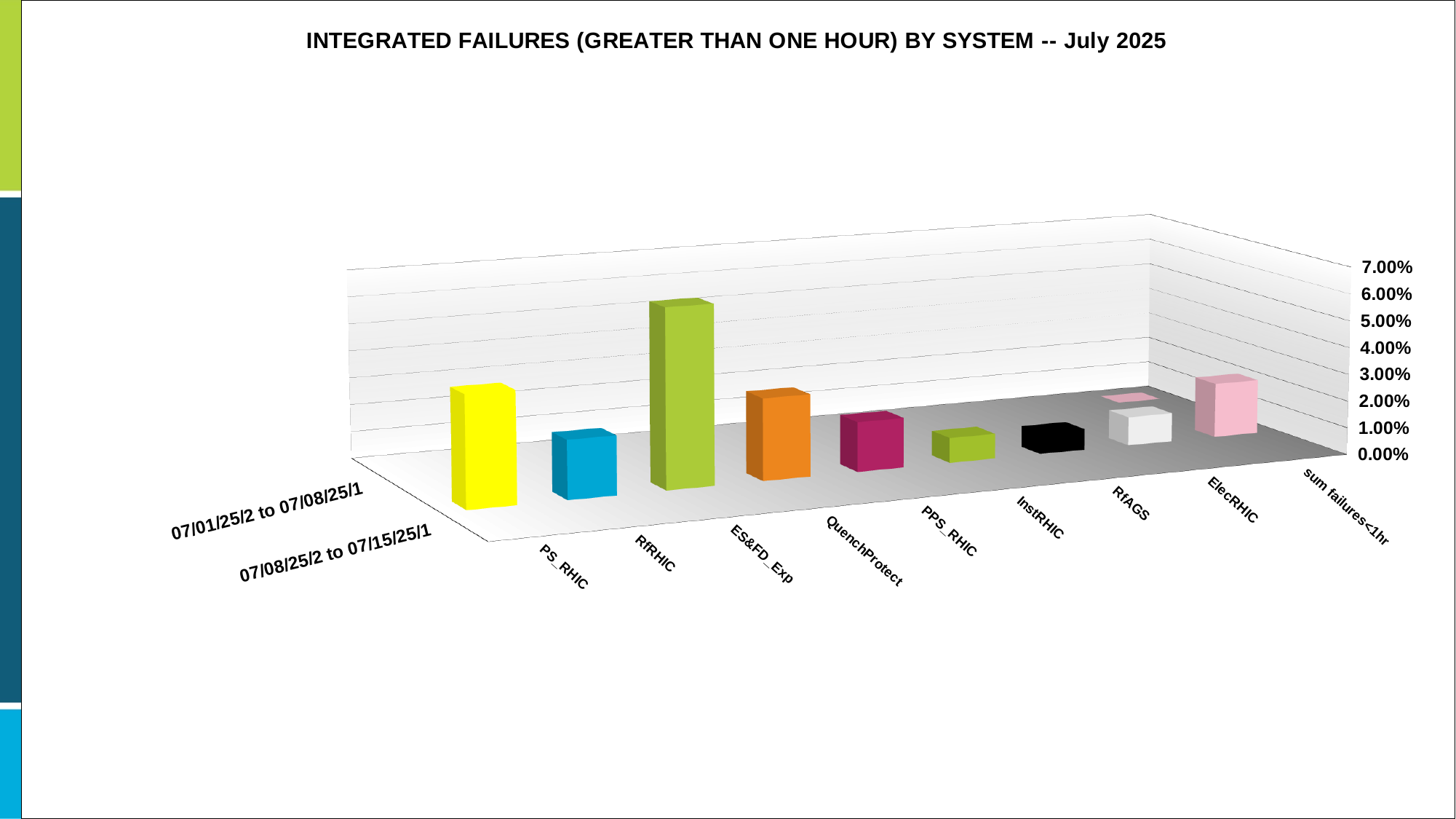
Is the value for PS_RHIC greater or less than 1.00%? greater How many date-range series are shown on the depth axis of the chart? 2 Which is larger, the bar for QuenchProtect or the bar for PPS_RHIC? QuenchProtect Which is larger, the bar for PS_RHIC or the bar for RfRHIC? PS_RHIC How many system categories are shown along the category axis? 9 Is the value for ES&FD_Exp greater or less than 2.00%? greater What is the title of the chart? INTEGRATED FAILURES (GREATER THAN ONE HOUR) BY SYSTEM -- July 2025 Is the value for RfAGS greater or less than 3.00%? less What kind of chart is shown on the slide? bar chart What is the maximum value shown on the vertical axis? 7.00% Which system has the highest bar in the chart? ES&FD_Exp Which is larger, the bar for ES&FD_Exp or the bar for QuenchProtect? ES&FD_Exp